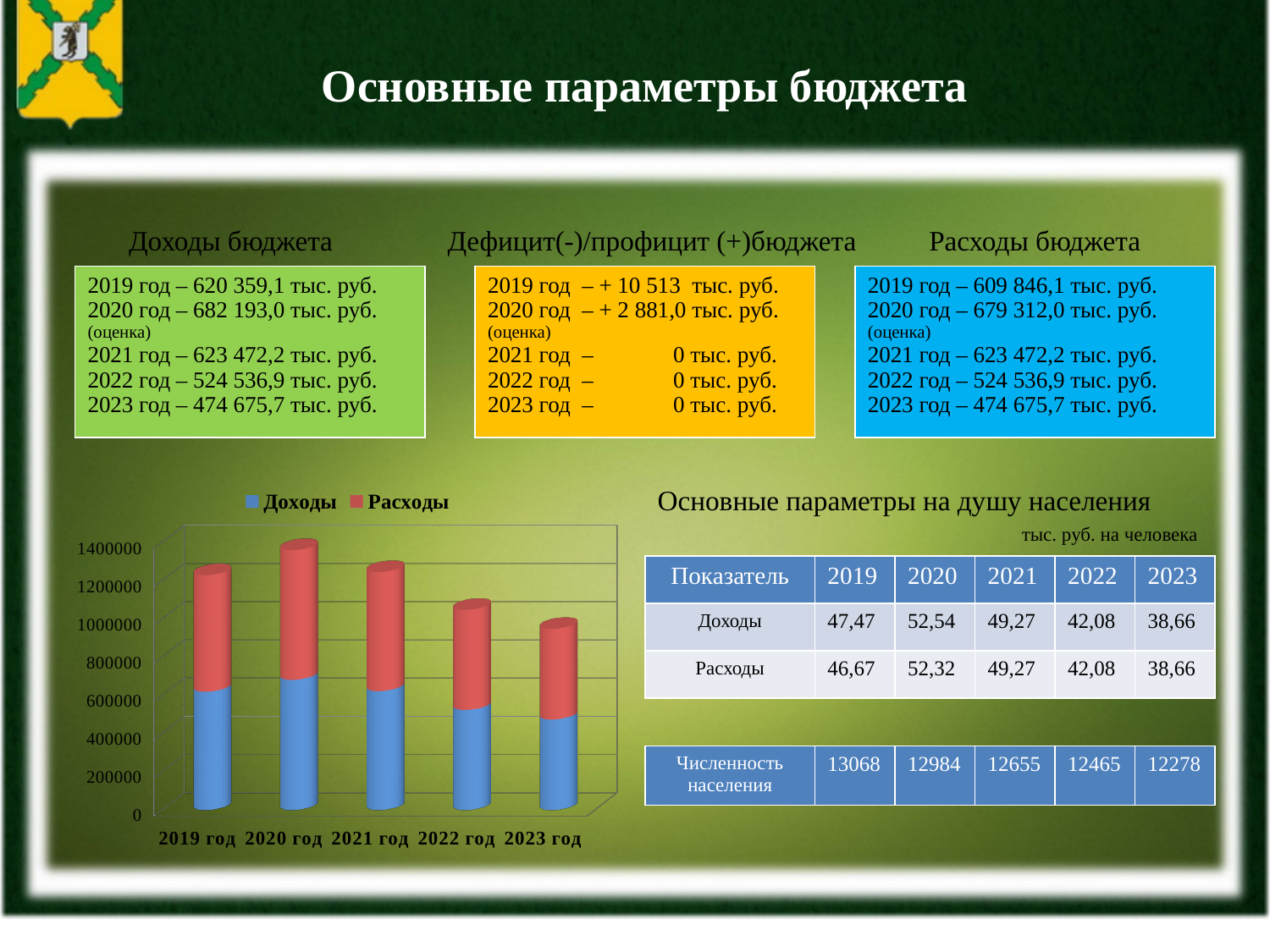
Is the total stacked bar for 2020 год greater or less than 1200000? greater Is the Доходы segment for 2023 год greater or less than 600000? less How many series does the chart legend list? 2 Which year has the highest Доходы segment in the chart? 2020 год Which colour represents Расходы in the chart legend? red What kind of chart is shown on the slide? bar chart Which year has the shortest stacked bar in the chart? 2023 год Do the stacked bars rise or fall from 2020 год to 2023 год? fall Which year has the tallest stacked bar in the chart? 2020 год Is the total stacked bar for 2023 год greater or less than 1000000? less Which stacked bar is taller, 2022 год or 2023 год? 2022 год How many years are shown on the x axis of the chart? 5